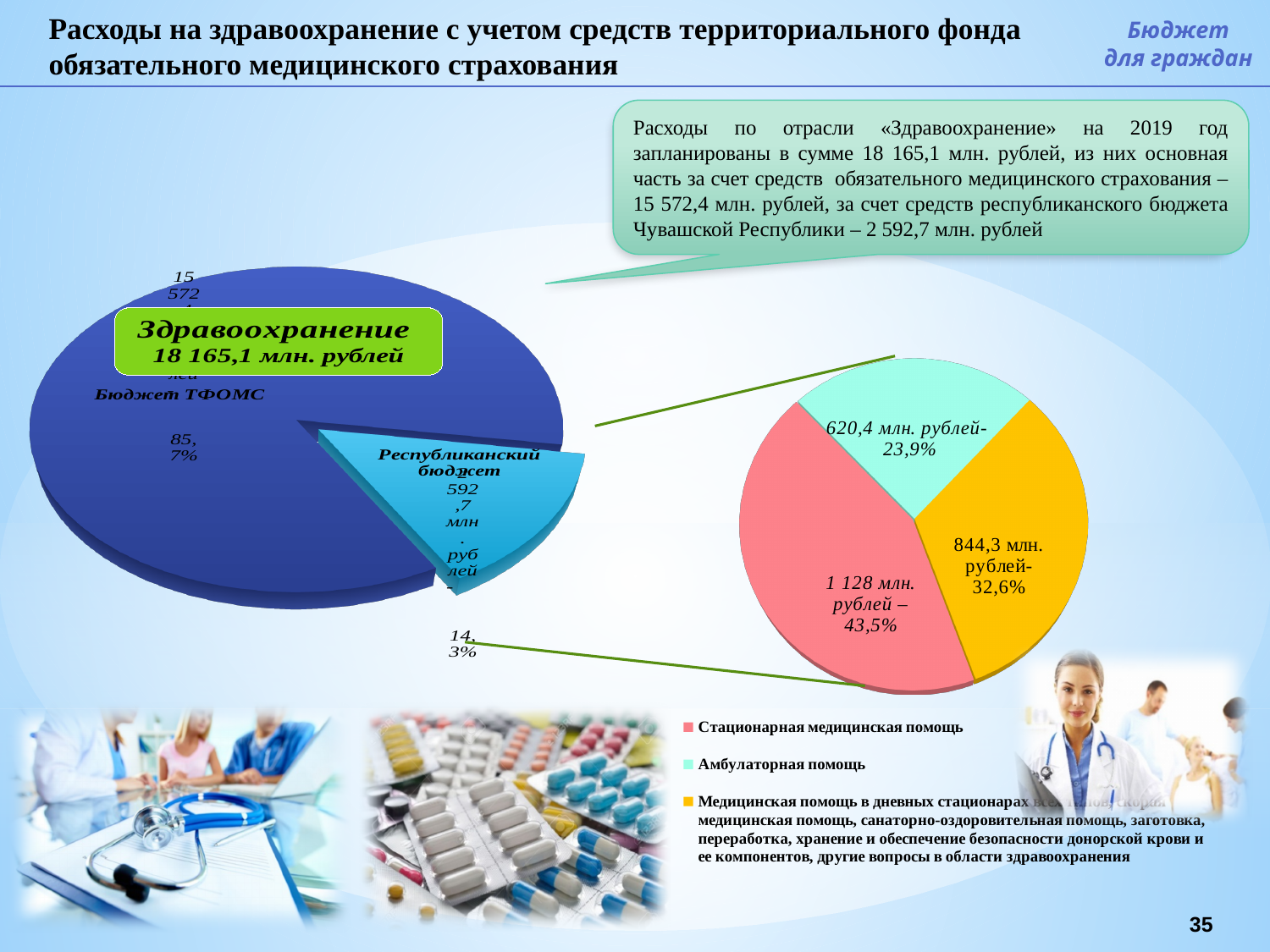
In the right pie chart, what is the value for Стационарная медицинская помощь? 1 128 млн. рублей In the left pie chart, what share does Бюджет ТФОМС have? 85,7% How many entries does the legend of the right pie chart list? 3 What kind of chart is the chart on the right of the slide? pie chart In the right pie chart, what share does Амбулаторная помощь have? 23,9% In the left pie chart, what share does Республиканский бюджет have? 14,3% In the right pie chart, which slice is the smallest? Амбулаторная помощь In the right pie chart, what is the value for Медицинская помощь в дневных стационарах (the yellow slice)? 844,3 млн. рублей In the right pie chart, which slice is the largest? Стационарная медицинская помощь In the left pie chart, which slice is larger: Бюджет ТФОМС or Республиканский бюджет? Бюджет ТФОМС What kind of chart is the chart on the left of the slide? pie chart How many slices does the left pie chart have? 2